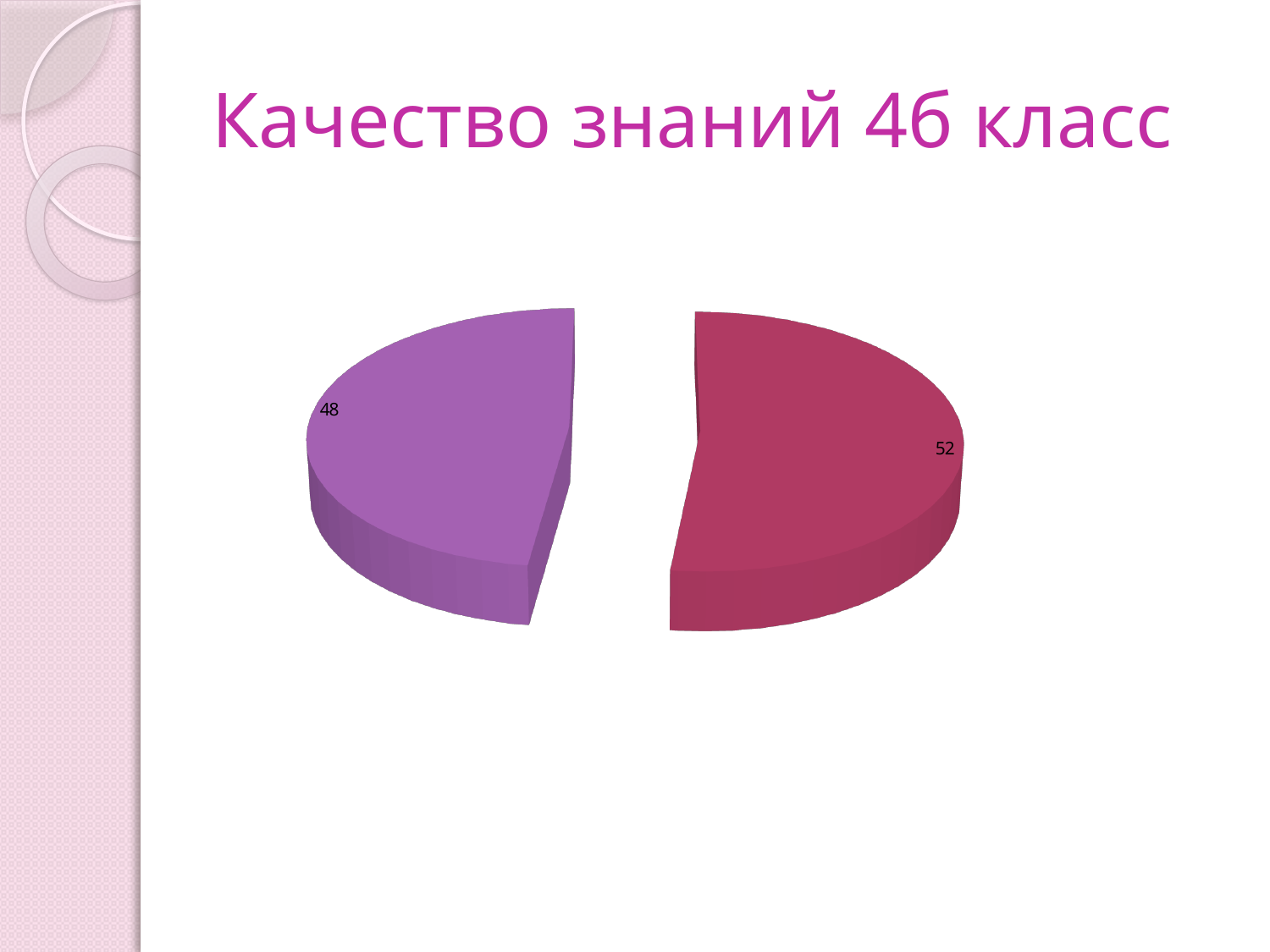
What is the title of the slide? Качество знаний 4б класс What kind of chart is shown on the slide? Pie chart How many slices does the pie chart have? 2 Is the red slice or the purple slice larger? The red slice Which slice of the pie chart is the smallest? The purple slice (48) What share of the pie does the purple slice represent? 48% What value is labelled on the purple slice of the pie chart? 48 What value is labelled on the red slice of the pie chart? 52 Does the pie chart have a legend? No What is the total of the two values shown on the pie chart? 100 What is the difference between the values of the red slice and the purple slice? 4 Which slice of the pie chart is the largest? The red slice (52)